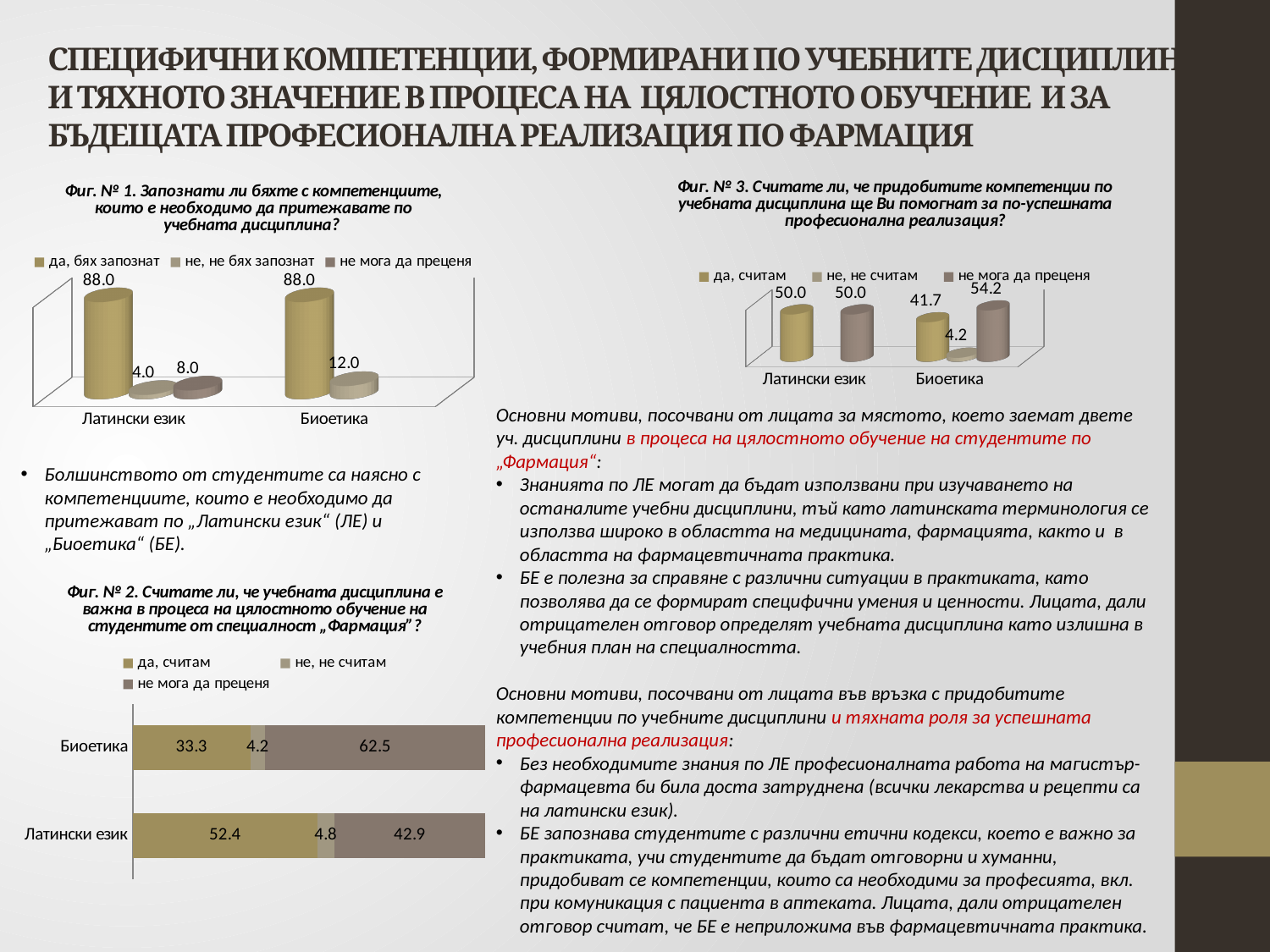
In Фиг. № 1, how many series does the legend list? 3 In Фиг. № 2, what is the value for "да, считам" for Биоетика? 33.3 In Фиг. № 3, what is the value for "не мога да преценя" for Биоетика? 54.2 In Фиг. № 2, which category has the larger "не мога да преценя" value, Биоетика or Латински език? Биоетика In Фиг. № 2, what is the value for "не мога да преценя" for Латински език? 42.9 In Фиг. № 1, what is the value for "да, бях запознат" for Латински език? 88.0 In Фиг. № 2, what is the difference between the "да, считам" values for Латински език and Биоетика? 19.1 In Фиг. № 3, how many categories are shown on the x axis? 2 In Фиг. № 1, what is the value for "не мога да преценя" for Латински език? 8.0 In Фиг. № 3, what is the value for "да, считам" for Латински език? 50.0 What kind of chart is Фиг. № 2? Stacked bar chart In Фиг. № 1, what is the value for "не, не бях запознат" for Биоетика? 12.0